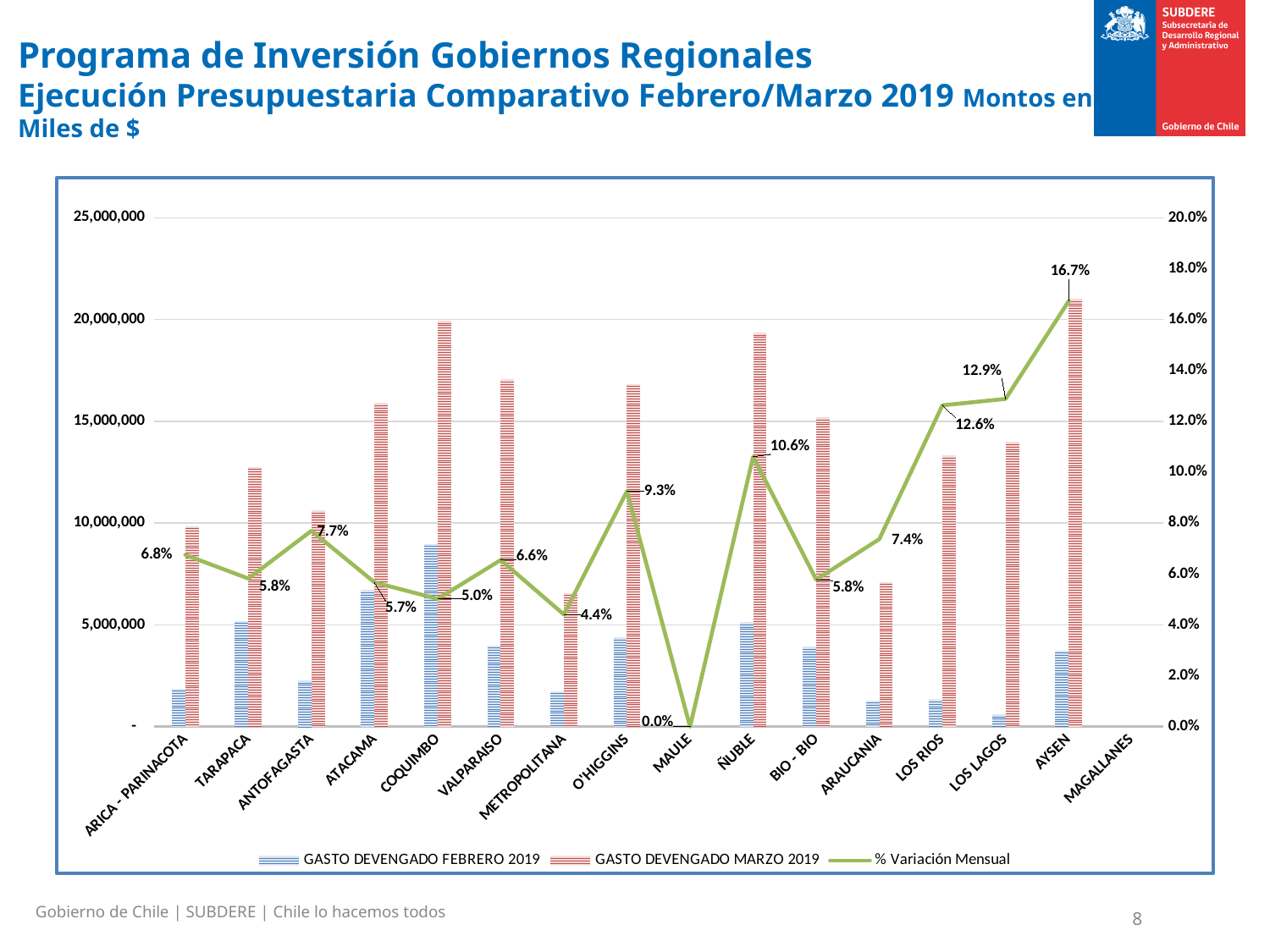
Which region has the highest % Variación Mensual? AYSEN What is the % Variación Mensual value shown for ÑUBLE? 10.6% Which has a higher % Variación Mensual, O'HIGGINS or ARAUCANIA? O'HIGGINS How many series does the chart legend list? 3 Is the GASTO DEVENGADO FEBRERO 2019 value for ARICA - PARINACOTA greater or less than 5,000,000? less What is the % Variación Mensual value shown for AYSEN? 16.7% What kind of chart is shown on the slide? A bar chart combined with a line chart What is the difference in % Variación Mensual between AYSEN and LOS LAGOS? 3.8 percentage points Is the GASTO DEVENGADO MARZO 2019 value for COQUIMBO greater or less than 15,000,000? greater Which region has the lowest % Variación Mensual among those with a labelled value? MAULE What is the % Variación Mensual value shown for METROPOLITANA? 4.4% How many regions are listed on the x axis of the chart? 16